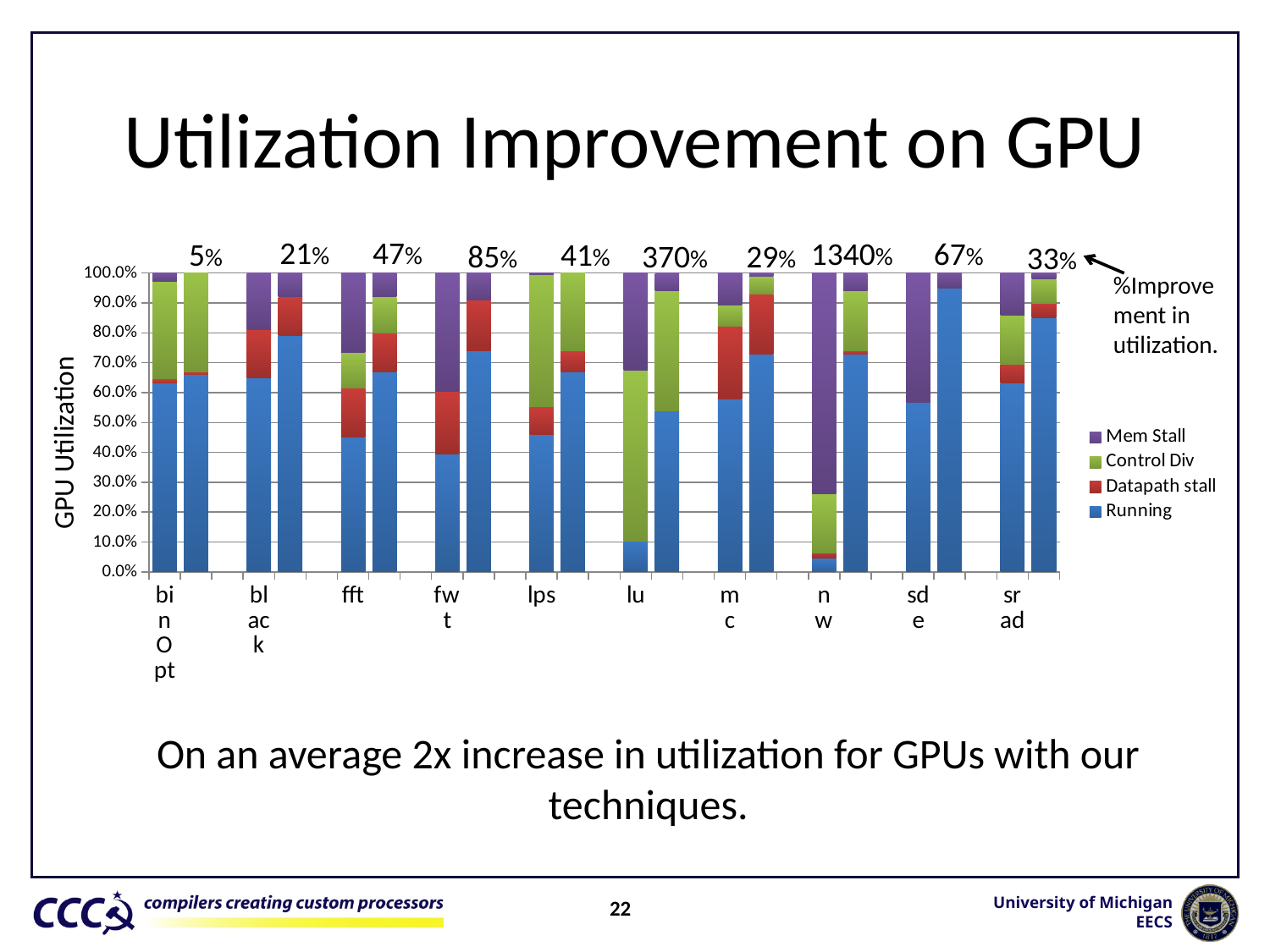
Is the Running value for the first (left) nw bar greater or less than 10.0%? less How many series does the chart legend list? 4 Which benchmark has the lowest printed % improvement in utilization? binOpt What is the % improvement in utilization printed above the fwt bars? 85% What is the label on the vertical axis of the chart? GPU Utilization Which benchmark has the highest printed % improvement in utilization? nw Is the Running value for the second (right) sde bar greater or less than 90.0%? greater Is the printed % improvement for fft larger or smaller than that for sde? smaller What is the % improvement in utilization printed above the lu bars? 370% What is the % improvement in utilization printed above the nw bars? 1340% How many benchmark categories are shown along the x axis? 10 What kind of chart is shown on the slide? stacked bar chart